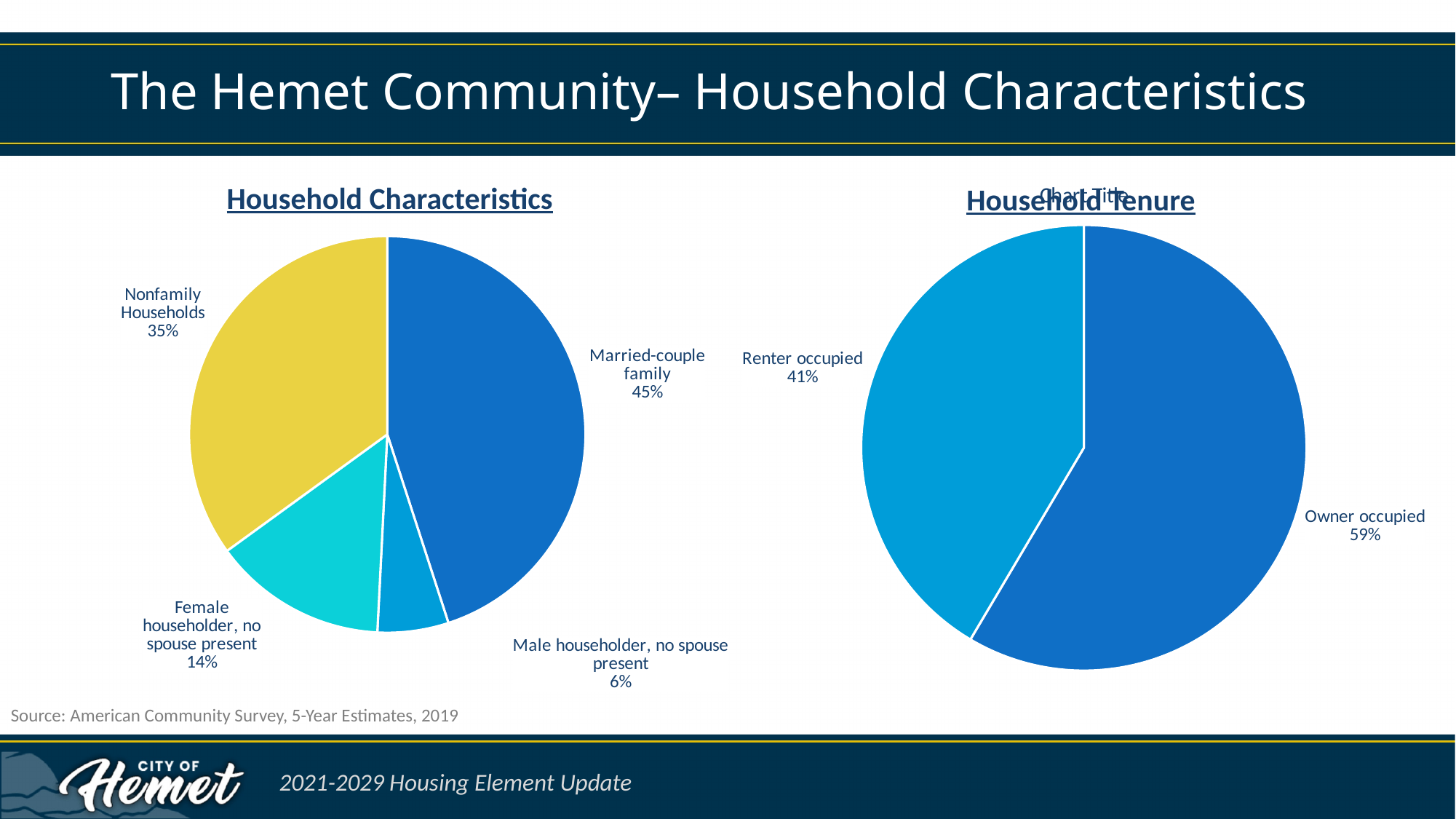
In the Household Tenure chart, which is larger, Owner occupied or Renter occupied? Owner occupied In the Household Characteristics chart, how many categories are shown? 4 In the Household Characteristics chart, what is the difference between the Married-couple family share and the Nonfamily Households share? 10% In the Household Characteristics chart, what share of households are Nonfamily Households? 35% In the Household Characteristics chart, which category has the largest share? Married-couple family In the Household Characteristics chart, which category has the smallest share? Male householder, no spouse present In the Household Tenure chart, what is the difference between the Owner occupied and Renter occupied shares? 18% What type of chart is the Household Tenure chart? Pie chart In the Household Characteristics chart, what share of households are Married-couple family? 45% In the Household Tenure chart, what share of households are Owner occupied? 59% In the Household Characteristics chart, what share is Female householder, no spouse present? 14% In the Household Tenure chart, what share of households are Renter occupied? 41%